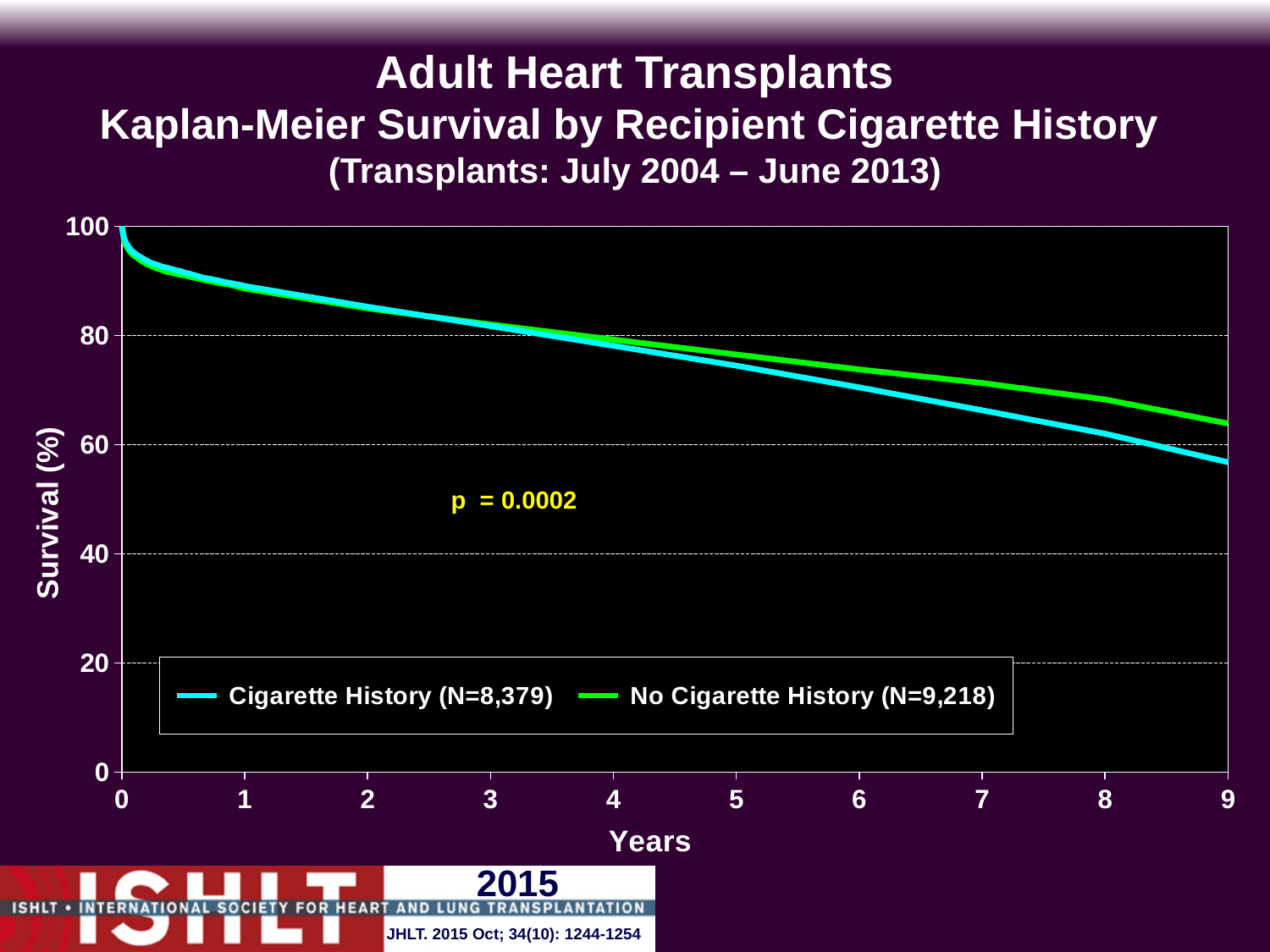
At 6 years, is the survival value for Cigarette History greater or less than 80? less How many series does the legend list? 2 What is the maximum value shown on the x axis (Years)? 9 Do the survival curves rise or fall as the years increase? fall What is the p-value shown on the chart? p = 0.0002 At 9 years, is the survival value for No Cigarette History greater or less than 60? greater At 9 years, is the survival value for Cigarette History greater or less than 60? less What is the N for the Cigarette History group in the legend? N=8,379 What kind of chart is shown on the slide? line chart At 9 years, which series has the higher survival: Cigarette History or No Cigarette History? No Cigarette History